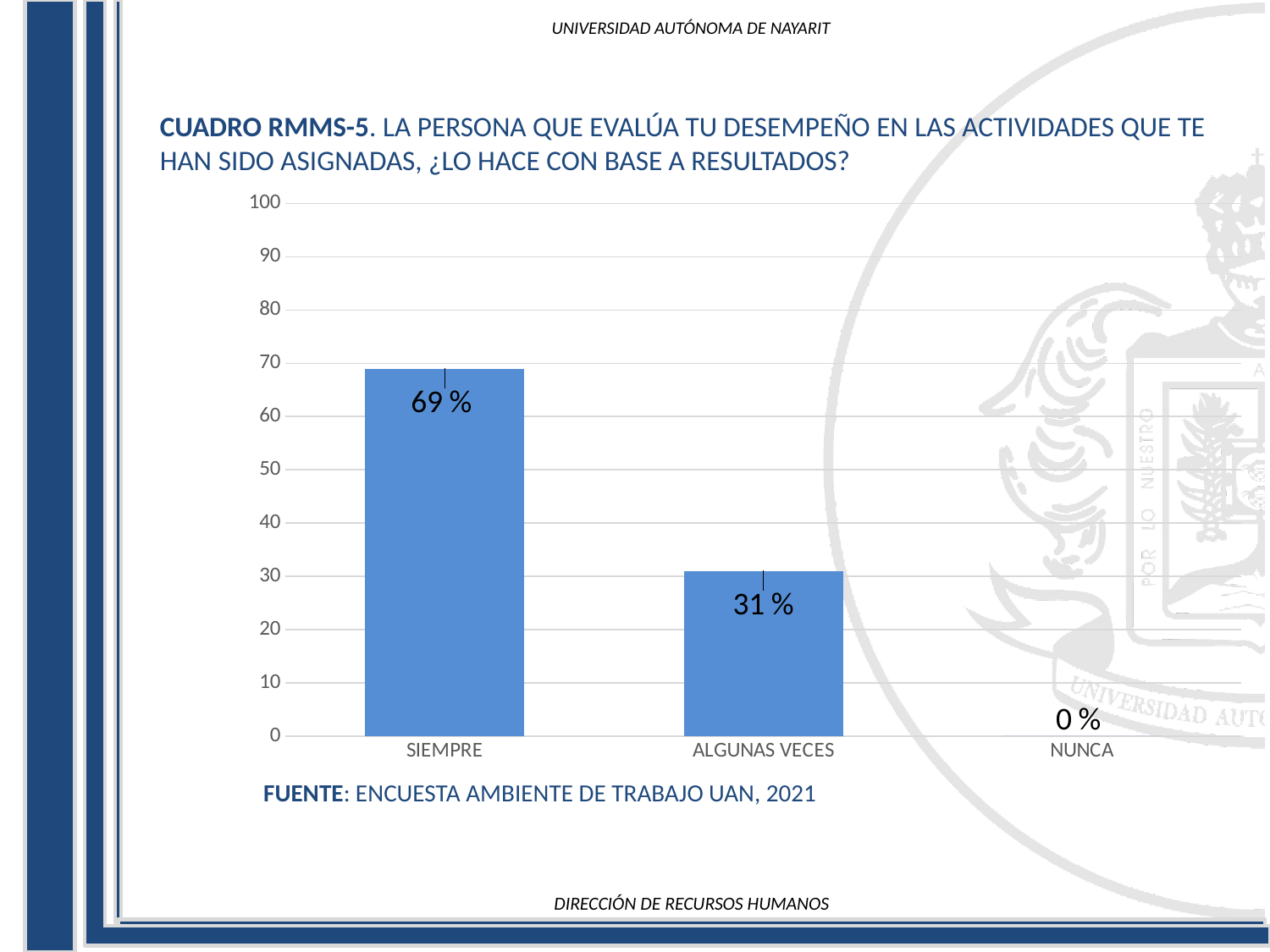
Which category has the lowest value? NUNCA Which category has the highest value? SIEMPRE How many categories are shown on the x axis? 3 What is the value for NUNCA? 0 % What is the value for SIEMPRE? 69 % What kind of chart is shown on the slide? bar chart What is the value for ALGUNAS VECES? 31 % Which is larger, the value for SIEMPRE or the value for ALGUNAS VECES? SIEMPRE What is the difference between the values for SIEMPRE and ALGUNAS VECES? 38 % Is the value for SIEMPRE greater or less than 60? greater What source is cited below the chart? ENCUESTA AMBIENTE DE TRABAJO UAN, 2021 Is the value for ALGUNAS VECES greater or less than 40? less